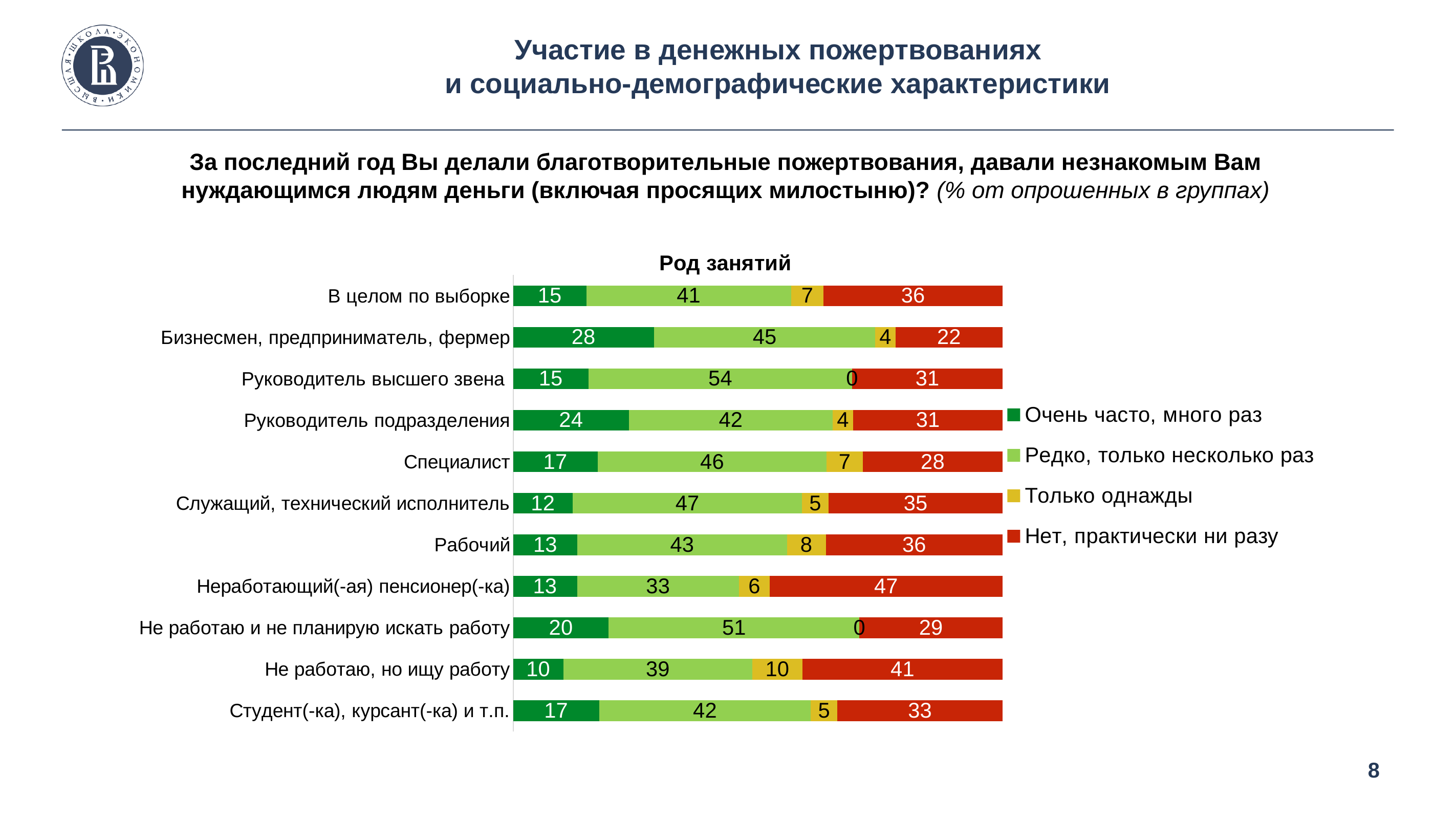
Which is larger: the 'Редко, только несколько раз' value for 'Специалист' or for 'Рабочий'? Специалист What is the difference between the 'Нет, практически ни разу' values for 'Неработающий(-ая) пенсионер(-ка)' and 'Бизнесмен, предприниматель, фермер'? 25 What is the value of 'Только однажды' for 'Не работаю, но ищу работу'? 10 What kind of chart is shown on the slide? Stacked bar chart How many series does the legend list? 4 Which category has the highest value for 'Очень часто, много раз'? Бизнесмен, предприниматель, фермер What is the total of the stacked bar for 'Руководитель высшего звена'? 100 Which category has the highest value for 'Редко, только несколько раз'? Руководитель высшего звена How many occupation categories are plotted in the chart? 11 What is the value of 'Очень часто, много раз' for 'Бизнесмен, предприниматель, фермер'? 28 What is the value of 'Нет, практически ни разу' for 'Неработающий(-ая) пенсионер(-ка)'? 47 Which category has the lowest value for 'Очень часто, много раз'? Не работаю, но ищу работу